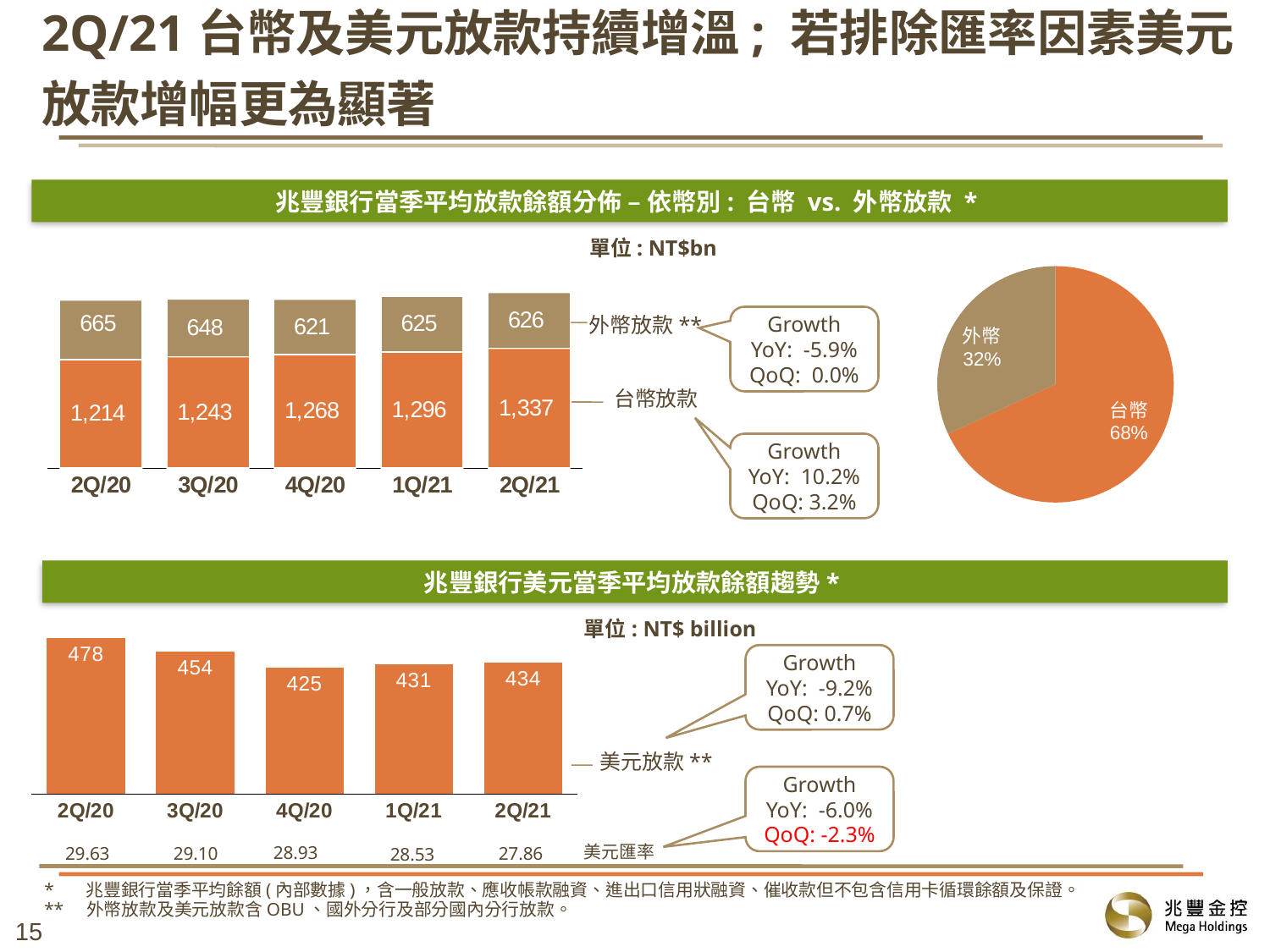
In the bottom bar chart, what is the difference between the 美元放款 values for 2Q/20 and 2Q/21? 44 In the top stacked bar chart, which quarter has the highest 台幣放款 value? 2Q/21 In the pie chart on the top right, what share does 外幣 have? 32% In the top stacked bar chart, what is the difference between 台幣放款 in 2Q/21 and 2Q/20? 123 What kind of chart is the bottom chart (兆豐銀行美元當季平均放款餘額趨勢)? bar chart In the top stacked bar chart, what is the total of the 2Q/20 stacked bar (台幣放款 plus 外幣放款)? 1,879 In the top stacked bar chart (兆豐銀行當季平均放款餘額分佈), what is the value of 台幣放款 for 2Q/21? 1,337 In the top stacked bar chart, how many quarters are shown on the x axis? 5 In the top stacked bar chart, what is the value of 外幣放款 for 4Q/20? 621 In the bottom bar chart, which quarter has the lowest 美元放款 value? 4Q/20 In the bottom chart, what is the 美元匯率 shown for 2Q/21? 27.86 In the bottom bar chart, what is the 美元放款 value for 4Q/20? 425